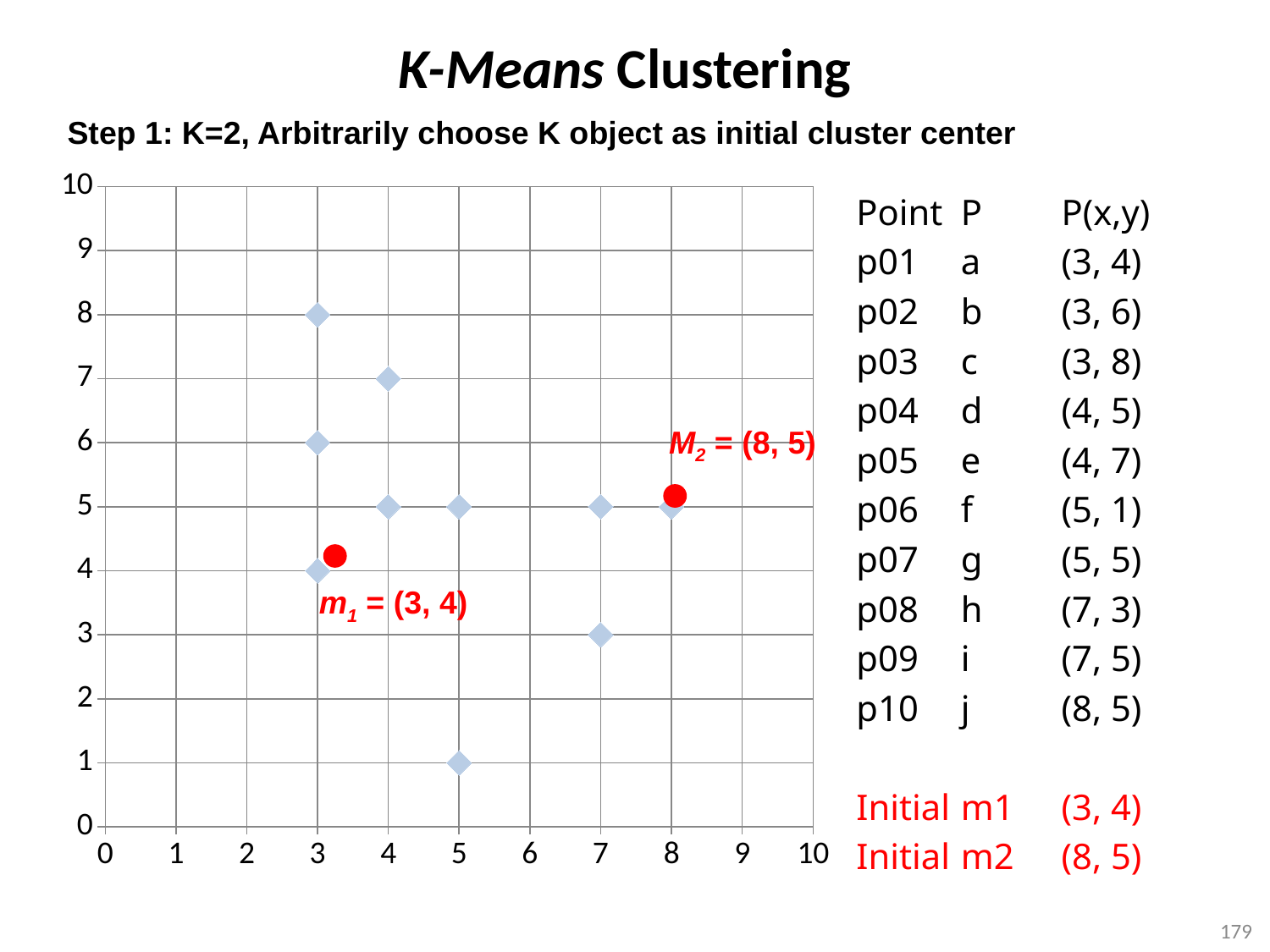
What colour are the two initial cluster center markers on the chart? red What is the difference in y value between point c (3, 8) and point f (5, 1)? 7 What are the coordinates of the initial cluster center m1 marked on the chart? (3, 4) What is the maximum value shown on the x axis of the chart? 10 Is the y value of point f greater or less than 5? less Which point has the largest x value on the chart? j (8, 5) Which has a larger y value, point e (4, 7) or point h (7, 3)? point e What are the coordinates of the initial cluster center M2 marked on the chart? (8, 5) Which point has the highest y value on the chart? c (3, 8) How many data points (blue diamonds) are plotted on the chart? 10 What kind of chart is shown on the slide? scatter chart Which point has the lowest y value on the chart? f (5, 1)